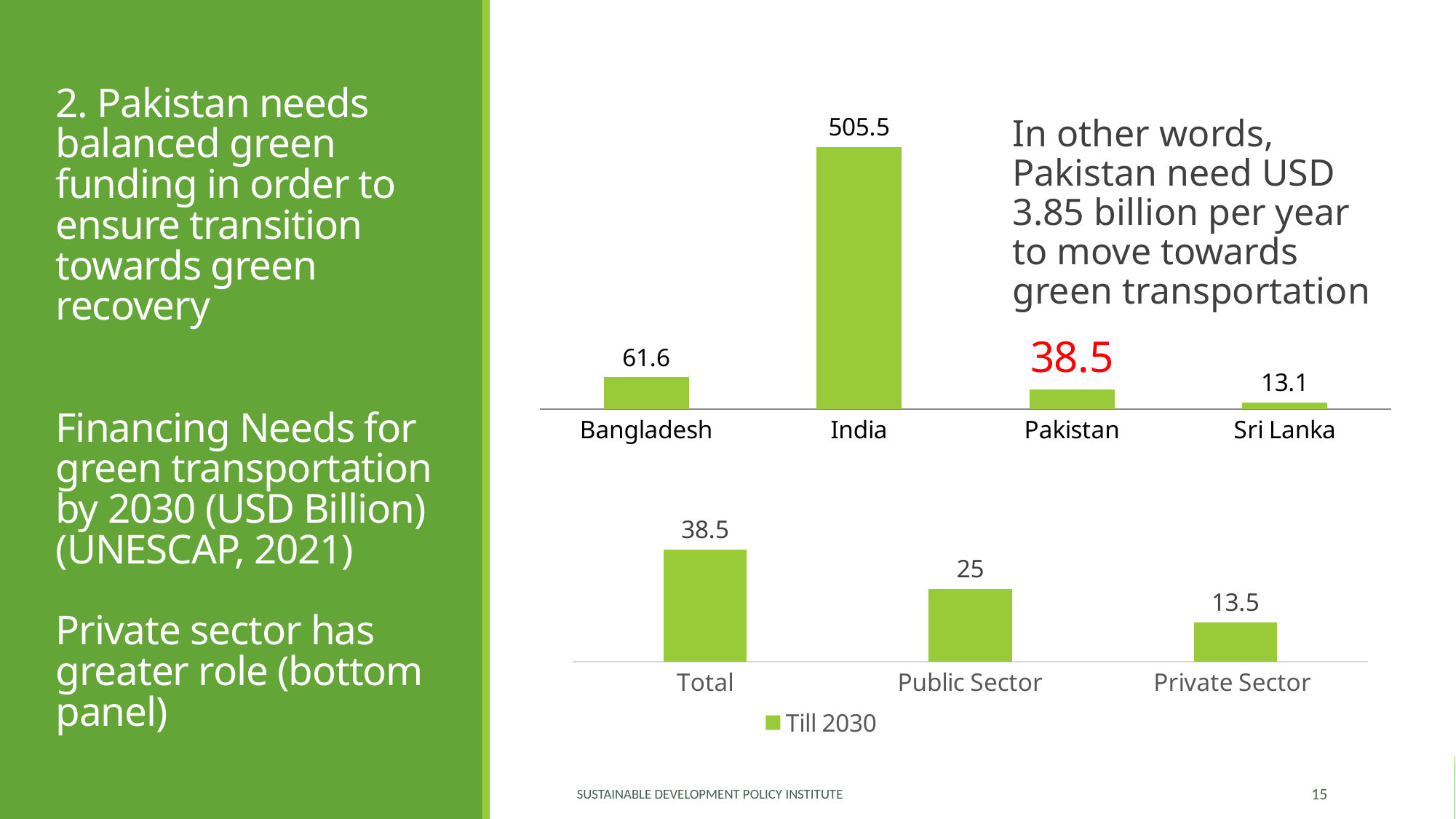
In the top chart, which country has the highest value? India In the bottom chart, what is the value for Private Sector? 13.5 What type of chart is the bottom chart? Bar chart How many countries are shown in the top chart? 4 In the bottom chart, what is the value for Public Sector? 25 What series name does the legend of the bottom chart show? Till 2030 In the bottom chart, what is the difference between the Public Sector and Private Sector values? 11.5 In the top chart, which is larger, the value for Bangladesh or the value for Sri Lanka? Bangladesh In the top chart, what is the difference between the values for Bangladesh and Pakistan? 23.1 In the top chart, what is the value for Pakistan? 38.5 In the top chart, which country has the lowest value? Sri Lanka In the top chart, what is the value for India? 505.5